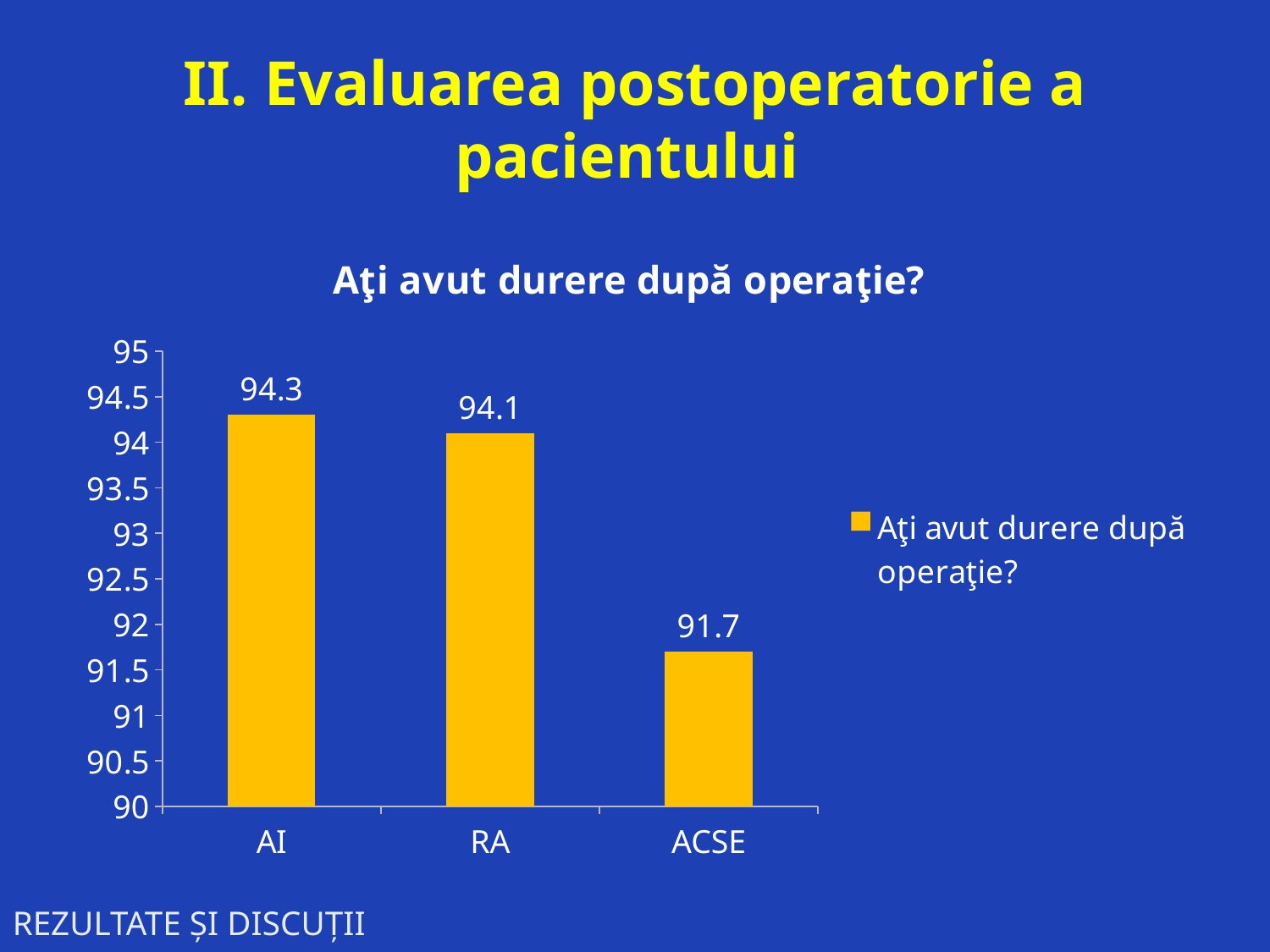
What kind of chart is shown on the slide? bar chart What is the value for RA? 94.1 What is the value for AI? 94.3 What is the value for ACSE? 91.7 What is the title of the chart? Aţi avut durere după operaţie? Which category has the highest value? AI What is the difference between the values for RA and ACSE? 2.4 How many categories are shown on the x axis? 3 What is the difference between the values for AI and ACSE? 2.6 Is the value for ACSE greater or less than 92? less Which category has the lowest value? ACSE Which is larger, the value for RA or the value for ACSE? RA